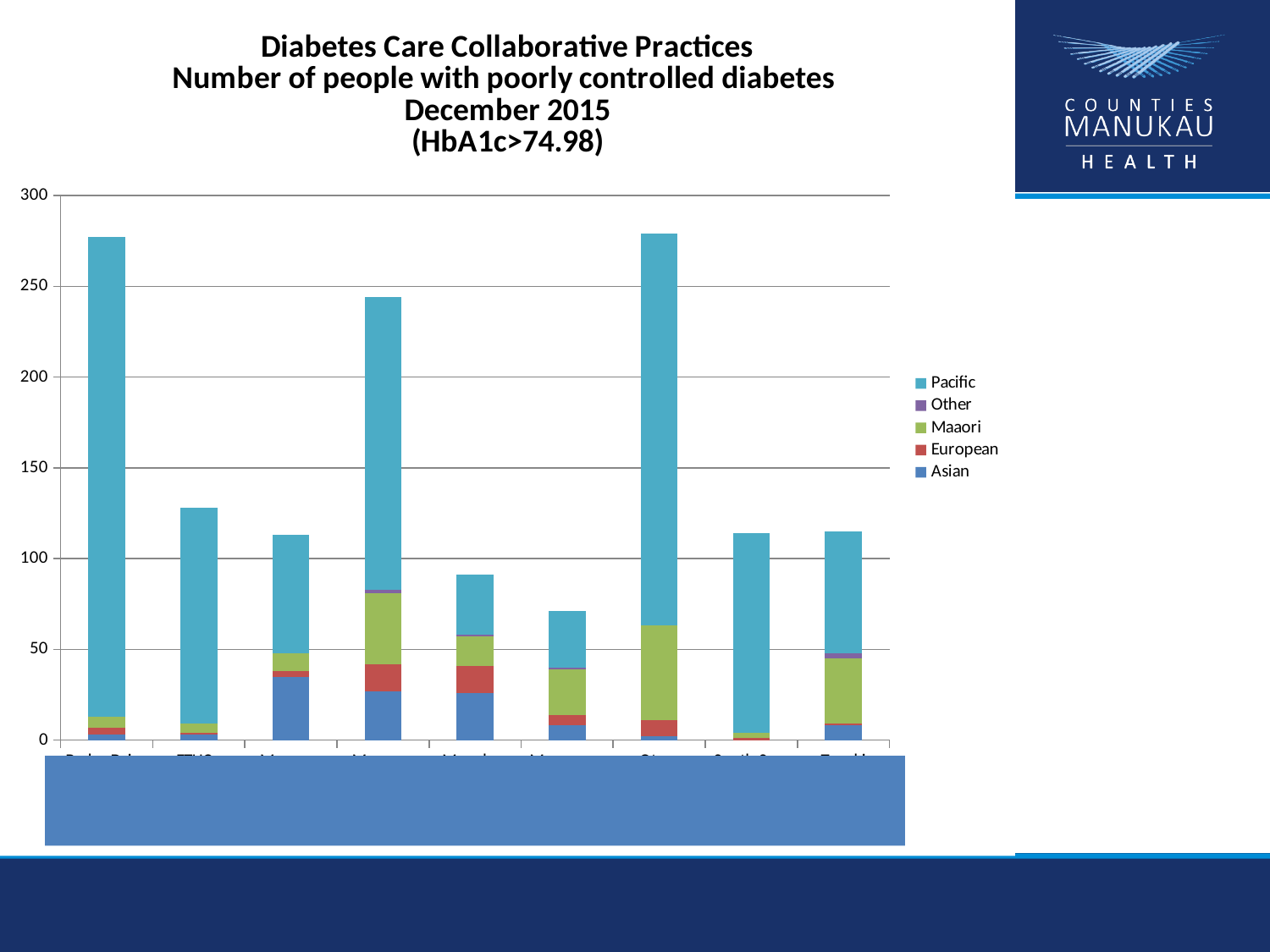
Is the total of the fourth bar from the left greater or less than 200? greater What kind of chart is shown on the slide? Stacked bar chart Which is taller, the seventh bar from the left or the eighth bar from the left? The seventh bar Which bar is the lowest in the chart? The sixth bar from the left Is the total of the sixth bar from the left greater or less than 100? less Which is taller, the fourth bar from the left or the second bar from the left? The fourth bar How many series does the legend list? 5 Which series is shown at the top of each stacked bar? Pacific Is the total of the first bar from the left greater or less than 250? greater How many bars (practices) are plotted in the chart? 9 Which series does the legend list last (at the bottom)? Asian